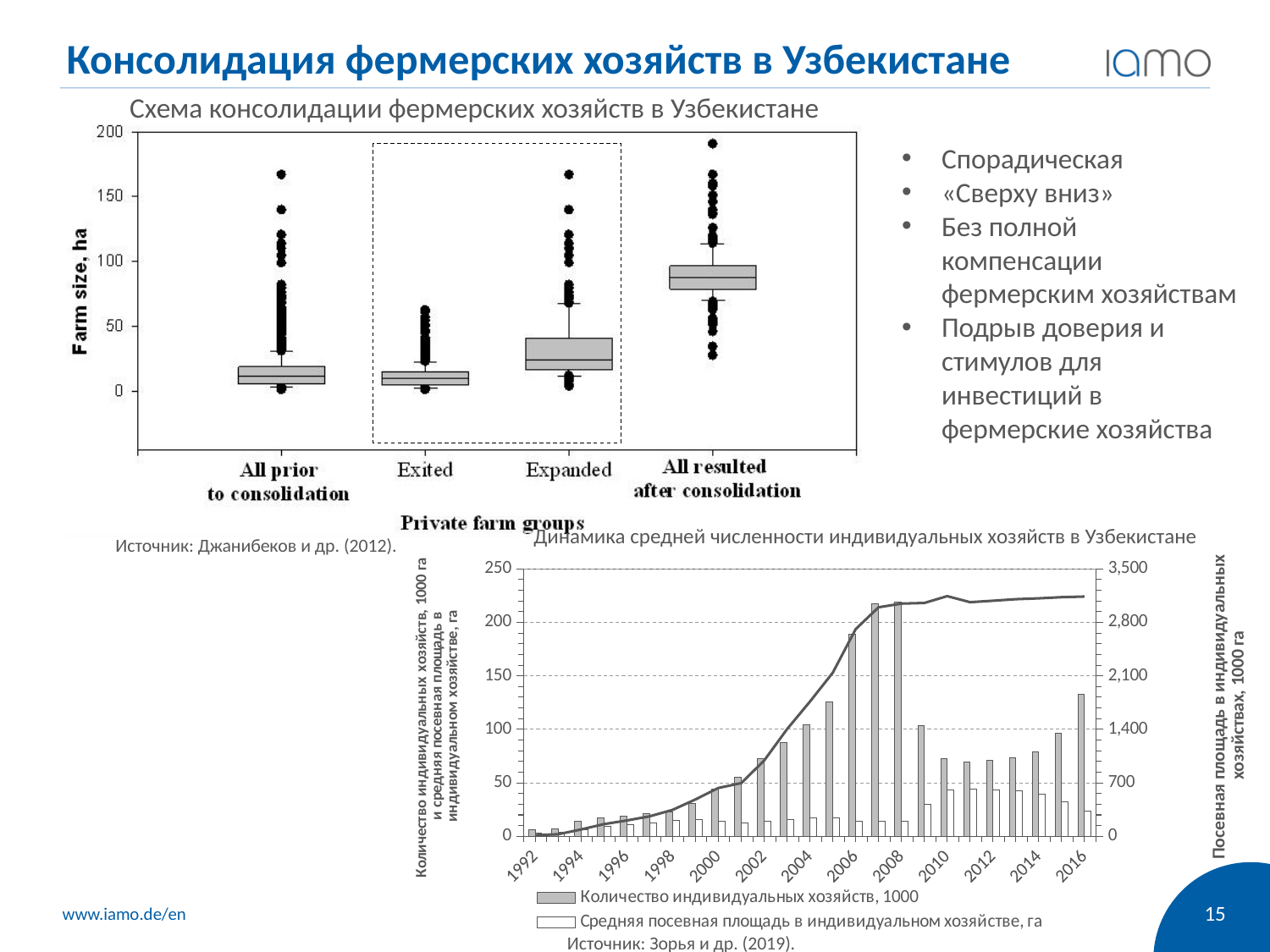
In the bottom chart, is the value of 'Количество индивидуальных хозяйств, 1000' for 2007 greater or less than 200? greater In the bottom chart, which year has the larger value of 'Количество индивидуальных хозяйств, 1000': 2006 or 2010? 2006 In the top-left box plot, what is the label of the y axis? Farm size, ha In the top-left box plot, which group has the higher median farm size: 'Expanded' or 'Exited'? Expanded What kind of chart is the top-left chart titled 'Схема консолидации фермерских хозяйств в Узбекистане'? box plot In the bottom chart, what is the first year shown on the x axis? 1992 In the bottom chart, does the line for sown area in individual farms generally rise or fall from 1992 to 2016? rise In the top-left box plot, how many private farm groups are shown on the x axis? 4 In the top-left box plot, is the median farm size for 'Exited' greater or less than 50 ha? less In the bottom chart 'Динамика средней численности индивидуальных хозяйств в Узбекистане', how many series does the legend list? 2 In the bottom chart, is the value of 'Количество индивидуальных хозяйств, 1000' for 2010 greater or less than 100? less